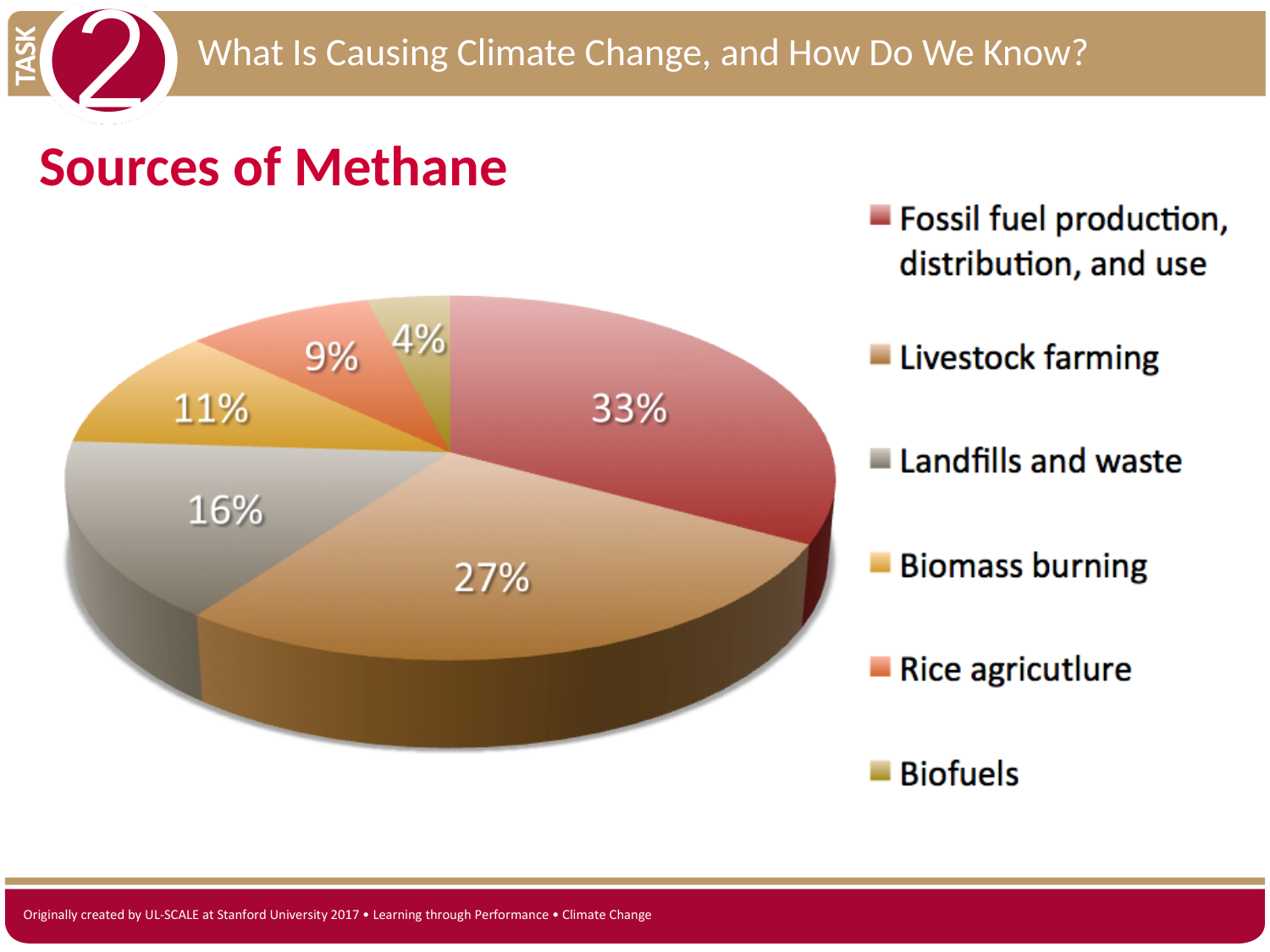
What share of methane sources does Fossil fuel production, distribution, and use account for? 33% Which source of methane has the smallest slice? Biofuels Which is larger, Biomass burning or Rice agriculture? Biomass burning Which source of methane has the largest slice? Fossil fuel production, distribution, and use What is the difference between the Landfills and waste share and the Biofuels share? 12 What percentage does Biomass burning contribute? 11% How many slices does the pie chart have? 6 What is the value shown for Landfills and waste? 16% How many percentage points larger is the Fossil fuel slice than the Livestock farming slice? 6 What share is shown for Rice agriculture? 9% What type of chart is shown on the slide? Pie chart What percentage of the pie is Livestock farming? 27%